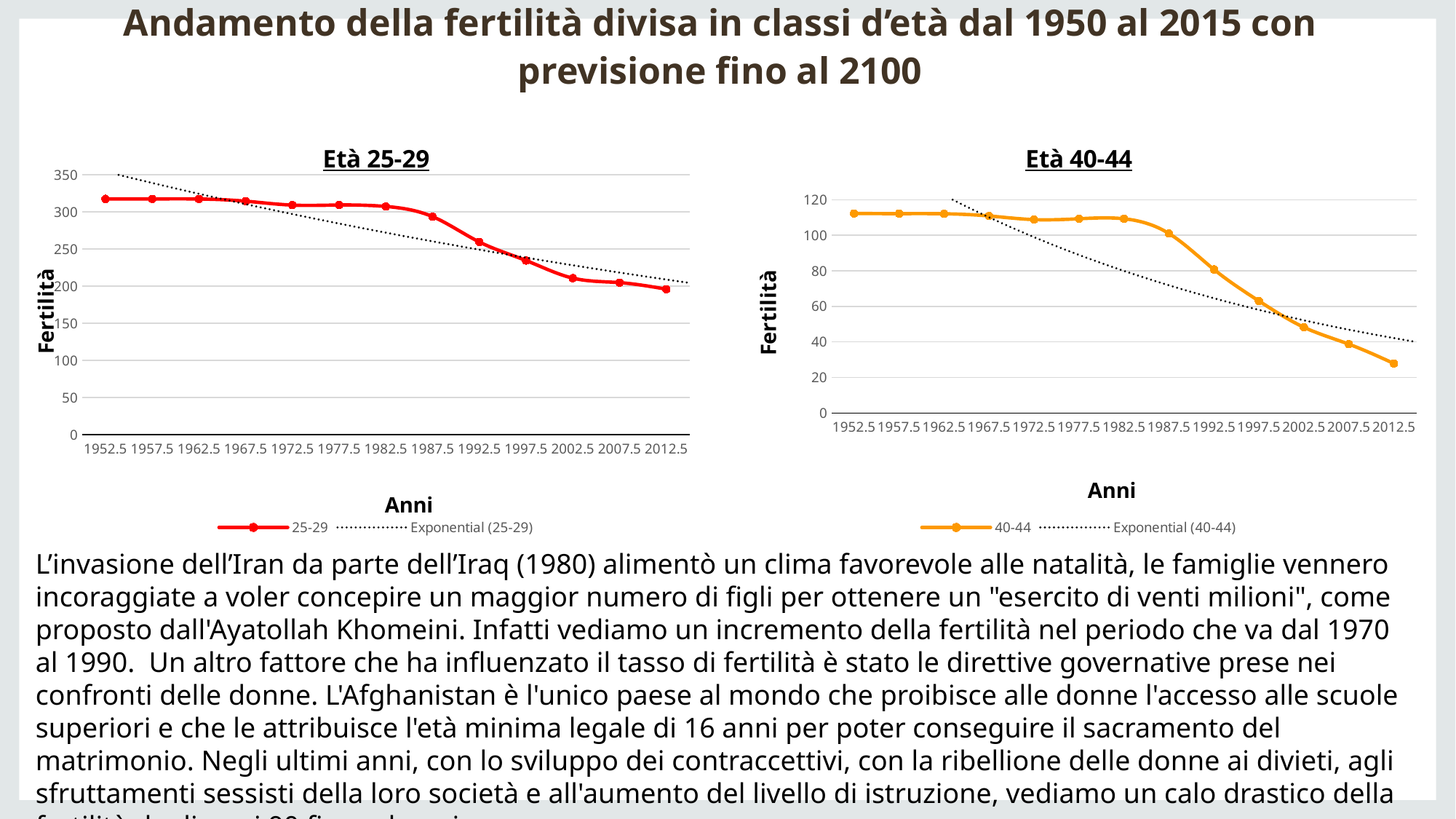
In the "Età 40-44" chart, is the value for 2012.5 greater or less than 40? less In the "Età 40-44" chart, is the value for 2002.5 greater or less than 60? less What colour is the data line in the "Età 40-44" chart? orange How many data points are plotted on the "Età 40-44" chart? 13 In the "Età 25-29" chart, is the value for 1992.5 greater or less than 250? greater What kind of chart is the "Età 25-29" chart? line chart In the "Età 25-29" chart, do the values rise or fall from 1952.5 to 2012.5? fall How many entries does the legend of the "Età 25-29" chart list? 2 What is the label of the y axis on the "Età 40-44" chart? Fertilità In the "Età 40-44" chart, which is larger, the value for 1952.5 or the value for 2012.5? 1952.5 In the "Età 40-44" chart, which year has the lowest fertility value? 2012.5